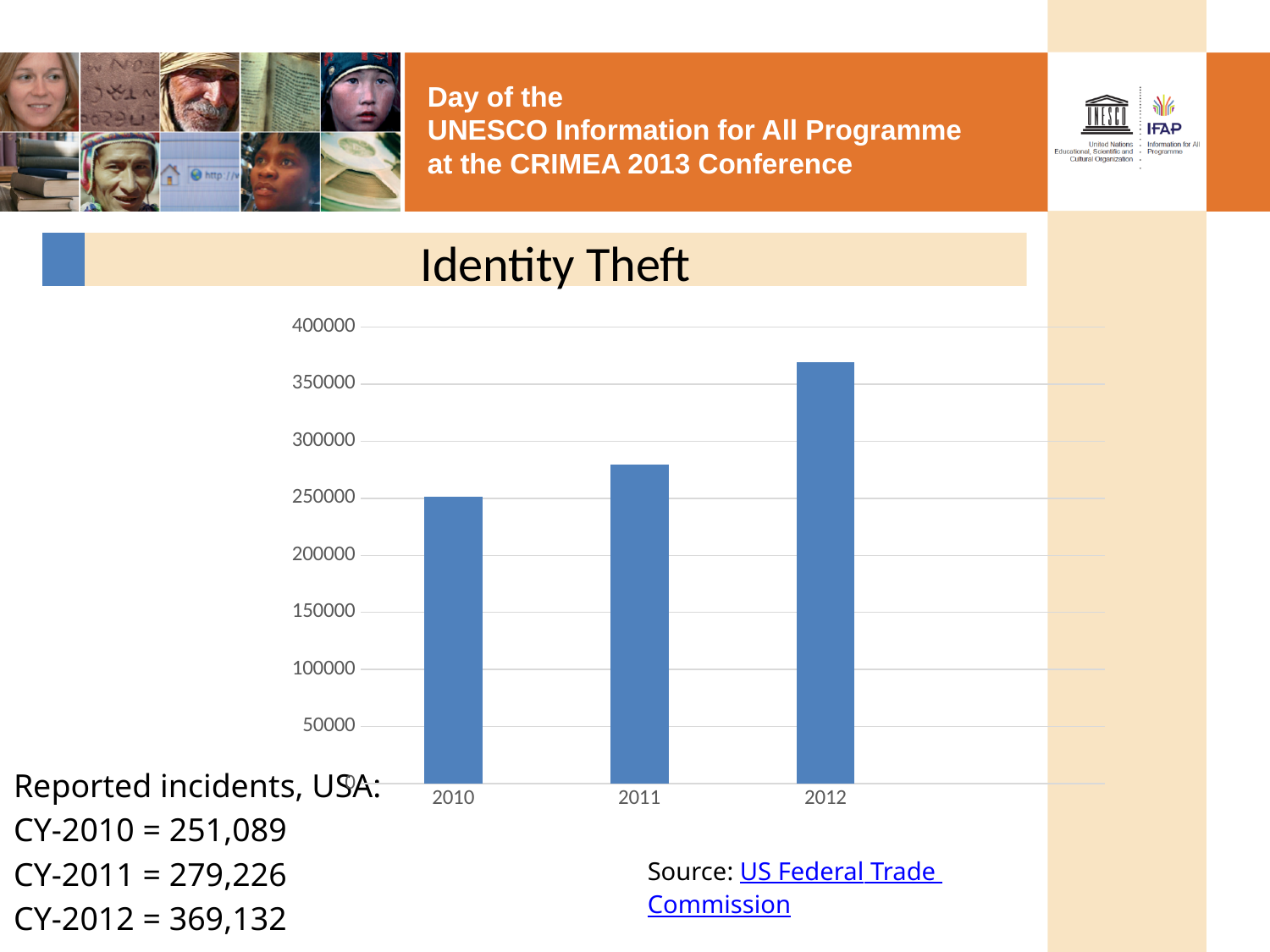
What is the difference between the reported incidents in 2012 and 2010? 118,043 Which year has the lowest number of reported incidents? 2010 What is the title of the chart? Identity Theft How many reported incidents were there in 2012? 369,132 What kind of chart is shown on the slide? bar chart How many reported incidents were there in 2010? 251,089 How many reported incidents were there in 2011? 279,226 Is the value for 2012 greater or less than 350000? greater Which is larger, the value for 2011 or the value for 2010? 2011 Do the values rise or fall from 2010 to 2012? rise Which year has the highest number of reported incidents? 2012 How many years are plotted on the chart? 3